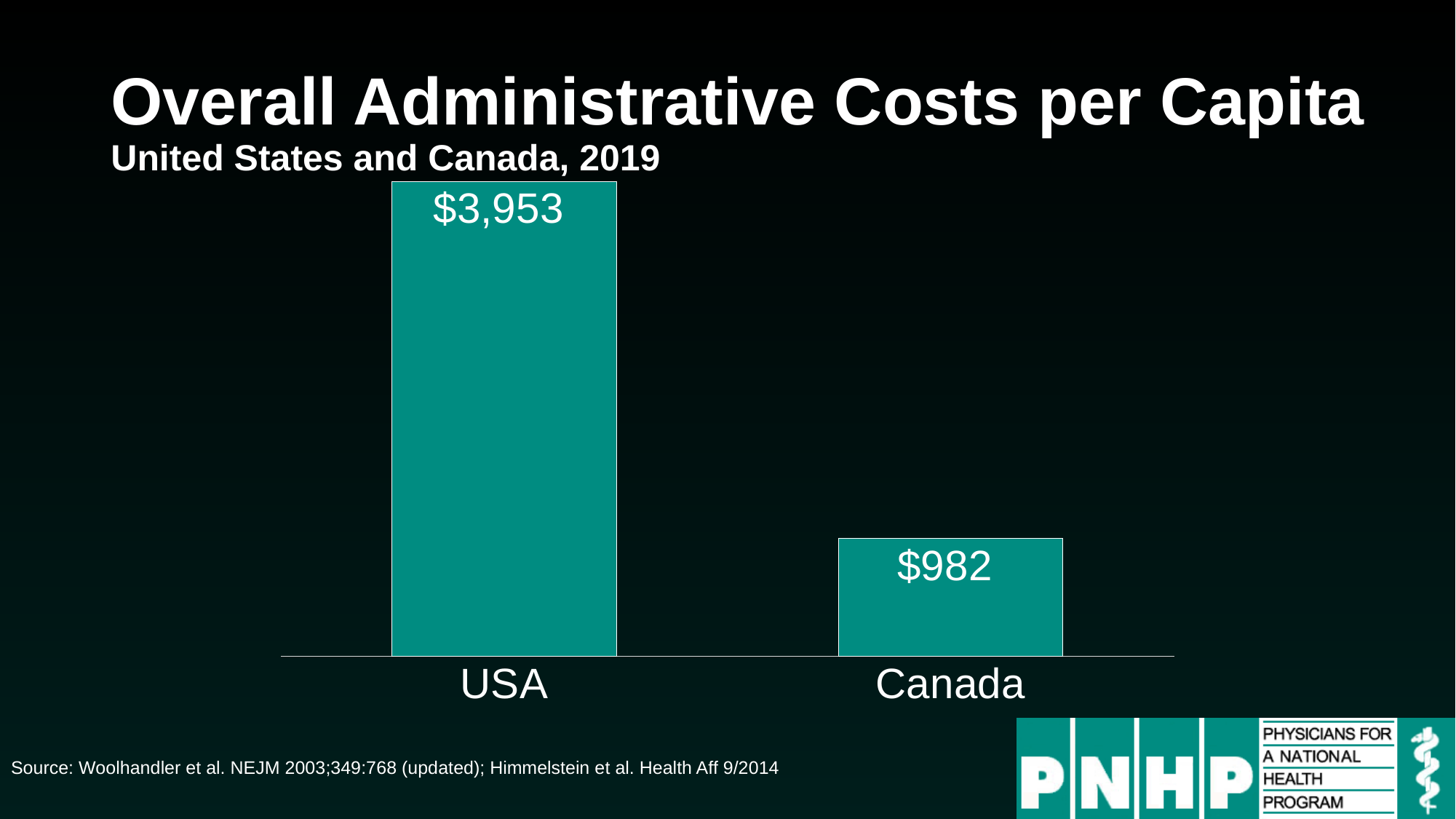
Which country has the higher administrative cost per capita? USA What is the title of the chart? Overall Administrative Costs per Capita Which country has the lower administrative cost per capita? Canada What is the overall administrative cost per capita for Canada? $982 What is the overall administrative cost per capita for the USA? $3,953 What kind of chart is shown on the slide? Bar chart How many countries are shown in the chart? 2 What is the difference between the USA and Canada administrative costs per capita? $2,971 Is the administrative cost per capita larger for the USA or for Canada? USA What year does the chart's subtitle refer to? 2019